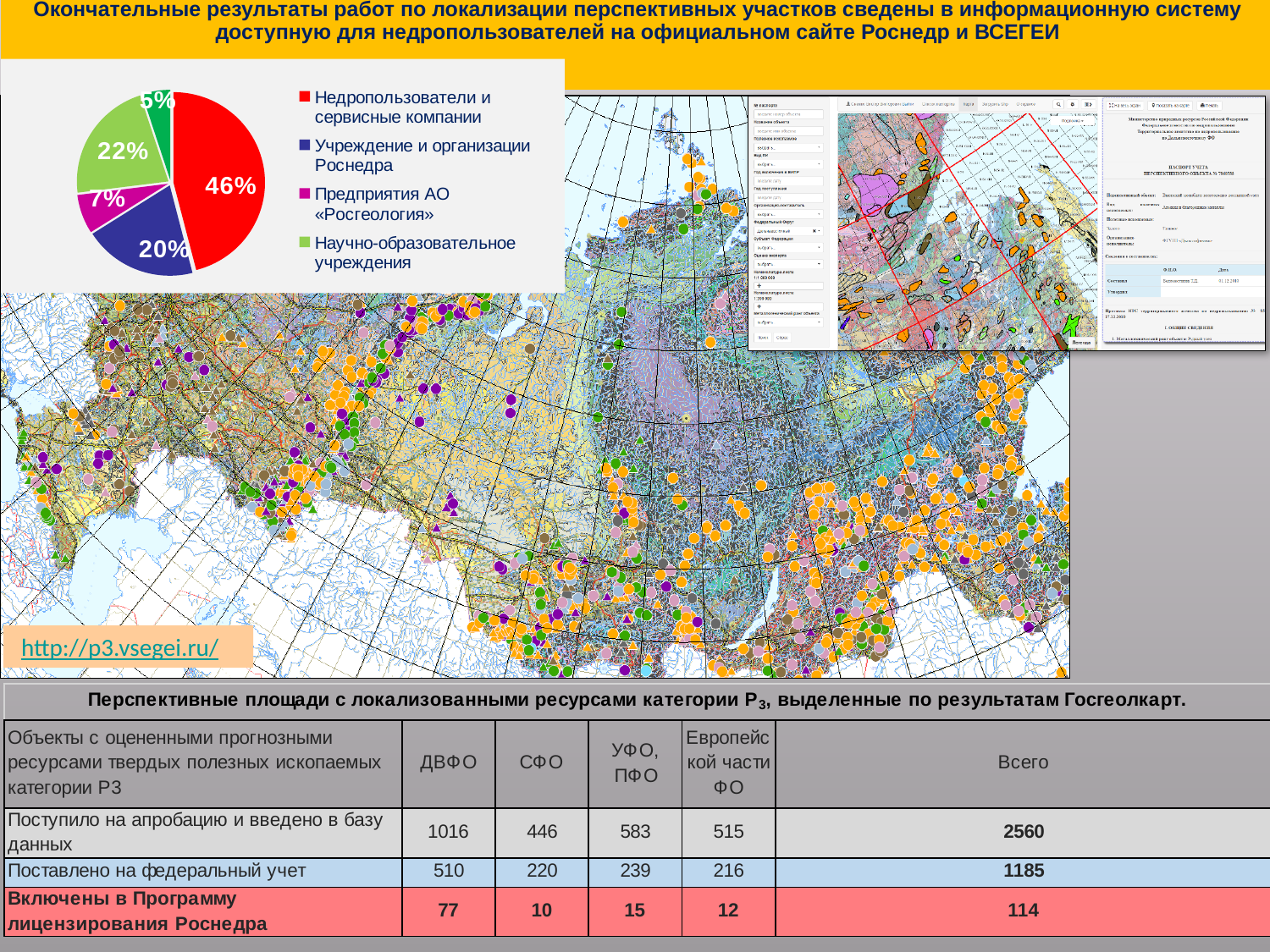
Which category has the largest slice in the pie chart? Недропользователи и сервисные компании In the pie chart, what share is shown for «Научно-образовательное учреждения»? 22% How many entries does the legend of the pie chart list? 4 How many slices does the pie chart have? 5 What is the smallest percentage labelled on the pie chart? 5% What colour is the slice for «Предприятия АО «Росгеология»» in the pie chart? magenta In the pie chart, which is larger: the share of «Научно-образовательное учреждения» or the share of «Учреждение и организации Роснедра»? Научно-образовательное учреждения What kind of chart is shown in the top-left of the slide? pie chart In the pie chart, what share is shown for «Недропользователи и сервисные компании»? 46% In the pie chart, what is the difference between the shares of «Недропользователи и сервисные компании» and «Учреждение и организации Роснедра»? 26% In the pie chart, what share is shown for «Предприятия АО «Росгеология»»? 7% In the pie chart, what share is shown for «Учреждение и организации Роснедра»? 20%